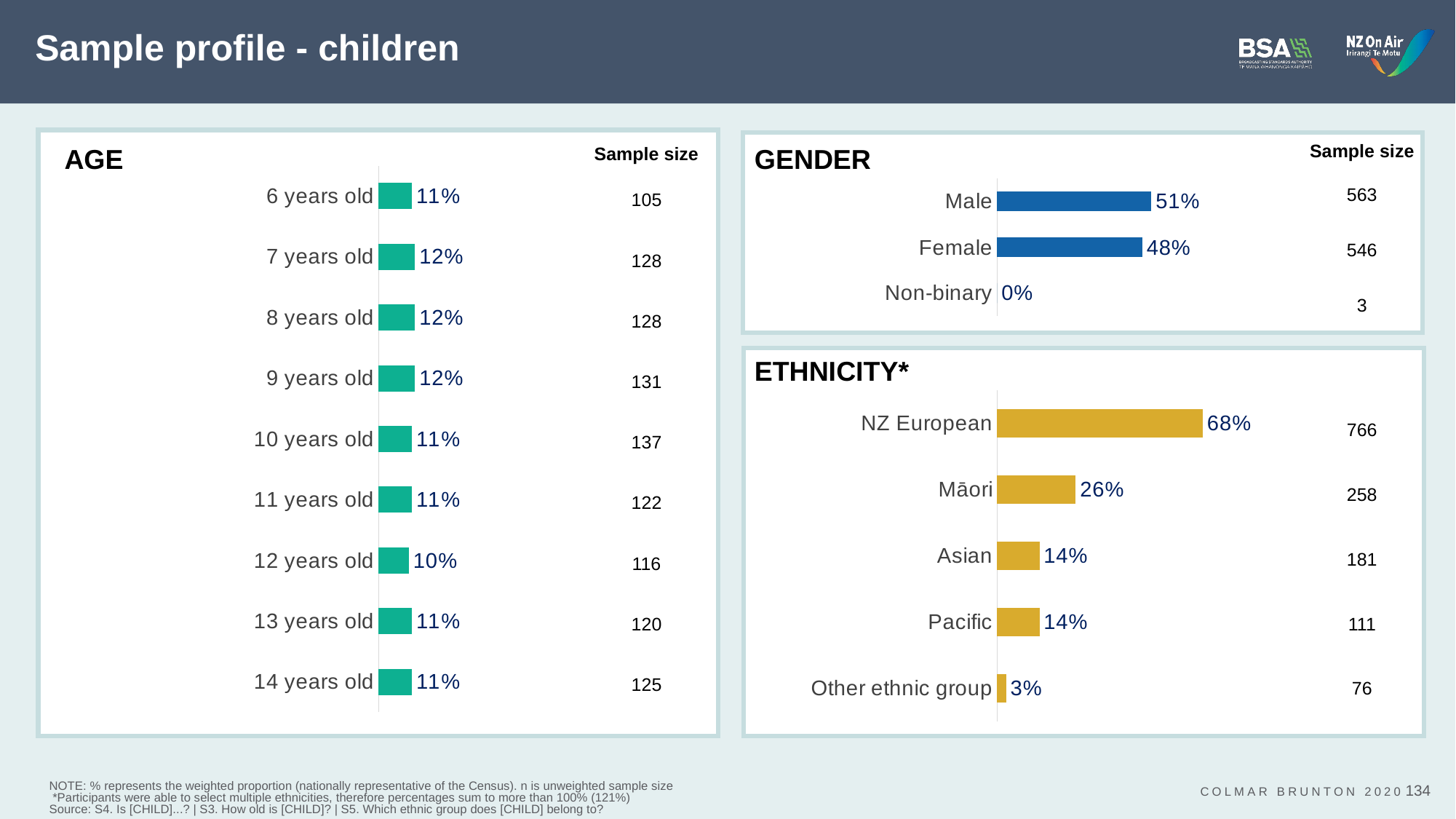
In the GENDER chart, what percentage is shown for Female? 48% In the ETHNICITY* chart, which has the larger sample size, Asian or Pacific? Asian In the AGE chart, which age group has the lowest percentage? 12 years old In the AGE chart, what is the sample size for 10 years old? 137 In the AGE chart, what percentage is shown for 12 years old? 10% In the AGE chart, how many age categories are plotted? 9 In the ETHNICITY* chart, what percentage is shown for Māori? 26% What type of chart is the ETHNICITY* chart? Bar chart In the GENDER chart, what is the sample size for Non-binary? 3 In the ETHNICITY* chart, what is the difference in percentage between NZ European and Māori? 42% In the ETHNICITY* chart, which ethnic group has the highest percentage? NZ European In the GENDER chart, what is the difference in percentage between Male and Female? 3%